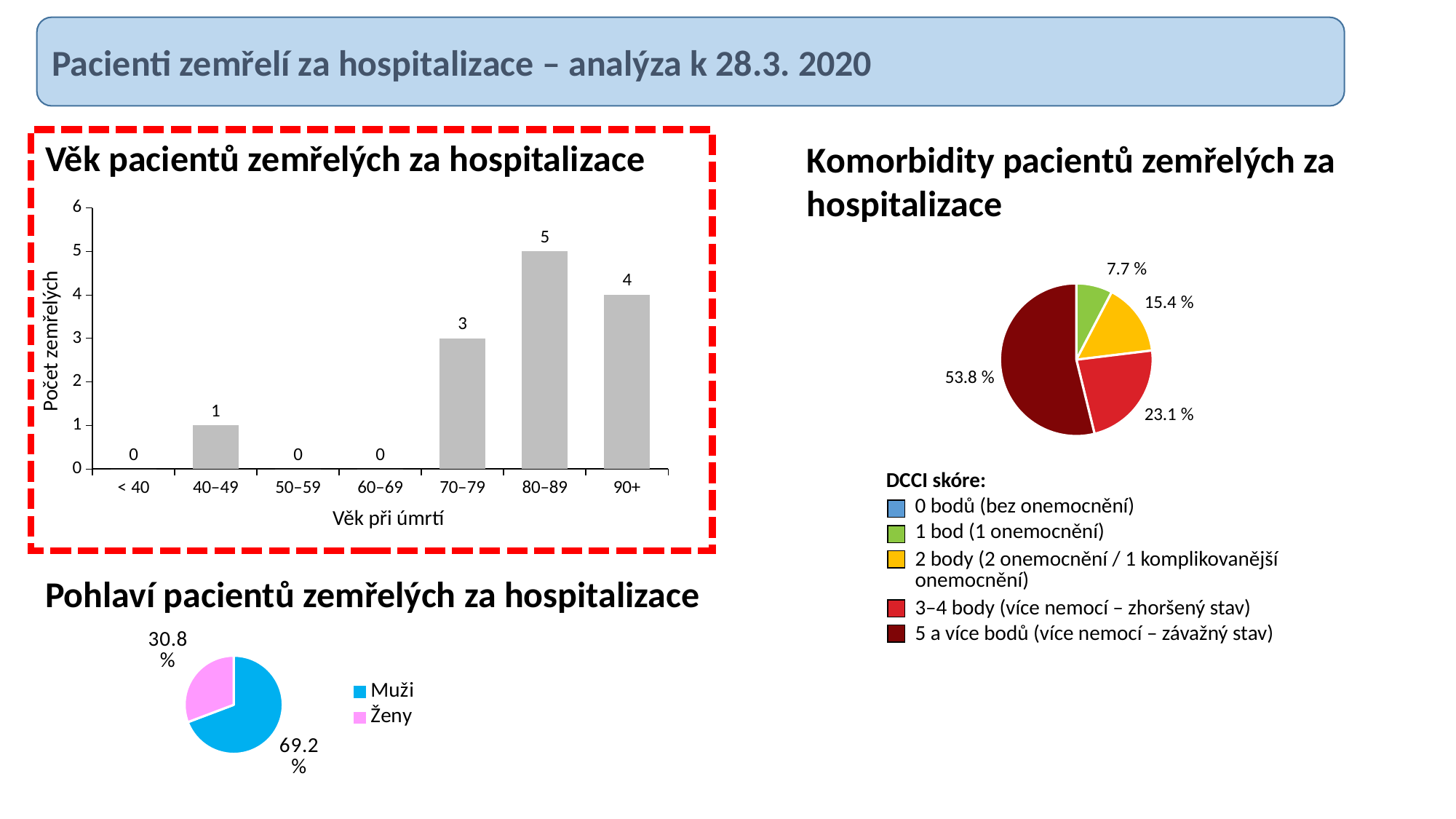
In the chart 'Věk pacientů zemřelých za hospitalizace', how many deaths are shown for the 80–89 age group? 5 In the chart 'Věk pacientů zemřelých za hospitalizace', what is the difference between the number of deaths in the 80–89 group and the 70–79 group? 2 In the pie chart 'Komorbidity pacientů zemřelých za hospitalizace', what share is shown for the '1 bod (1 onemocnění)' category? 7.7 % In the chart 'Věk pacientů zemřelých za hospitalizace', how many deaths are shown for the 40–49 age group? 1 In the chart 'Věk pacientů zemřelých za hospitalizace', which has more deaths: the 90+ group or the 70–79 group? 90+ In the pie chart 'Komorbidity pacientů zemřelých za hospitalizace', what share is shown for the '5 a více bodů' category? 53.8 % How many entries does the legend of the pie chart 'Pohlaví pacientů zemřelých za hospitalizace' list? 2 In the pie chart 'Pohlaví pacientů zemřelých za hospitalizace', what share is shown for Muži? 69.2 % In the chart 'Věk pacientů zemřelých za hospitalizace', which age group has the highest number of deaths? 80–89 What type of chart is 'Věk pacientů zemřelých za hospitalizace'? bar chart How many age categories are shown on the x axis of the chart 'Věk pacientů zemřelých za hospitalizace'? 7 In the chart 'Věk pacientů zemřelých za hospitalizace', what is the label of the y axis? Počet zemřelých